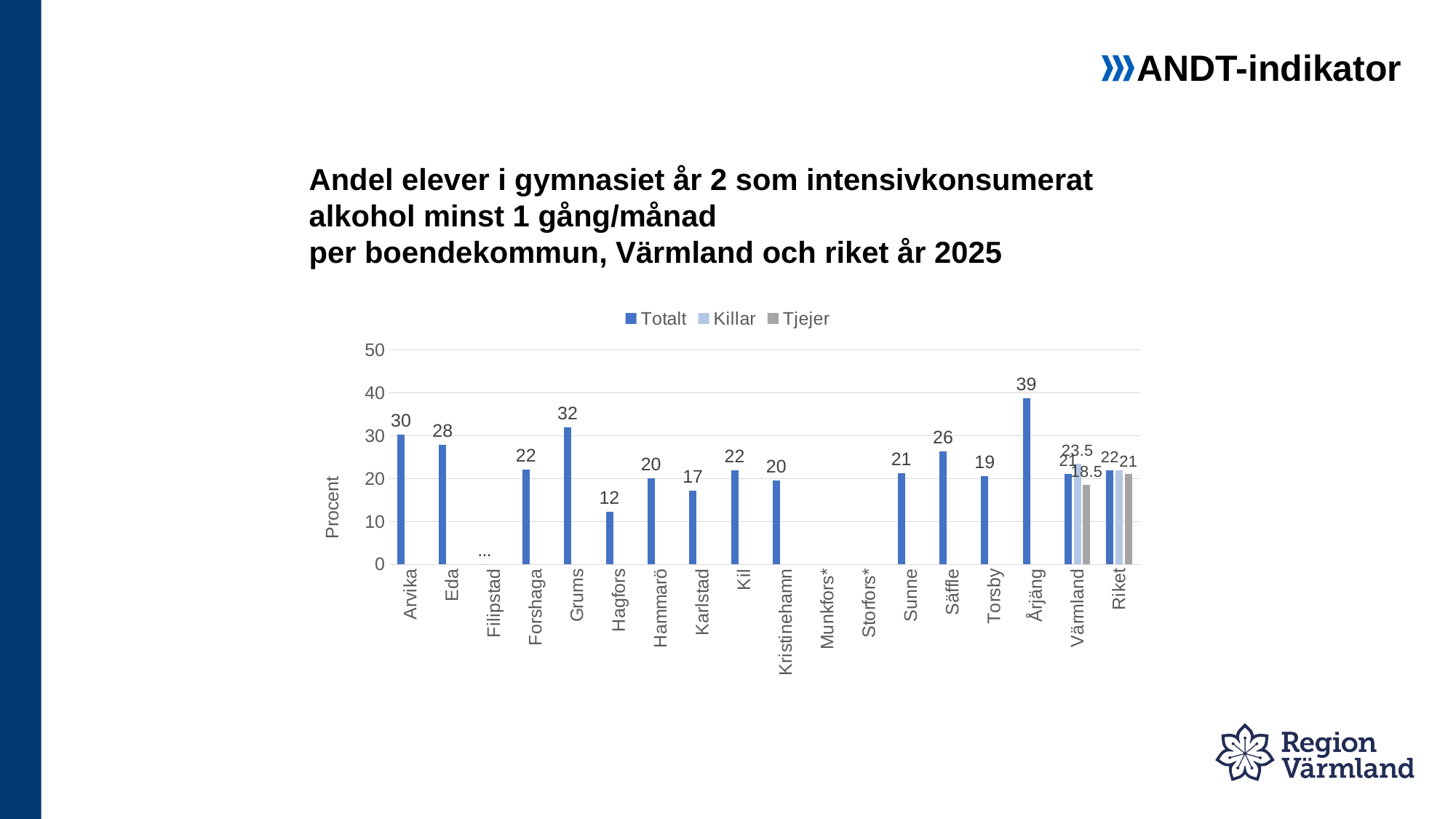
What is the Tjejer value for Värmland? 18.5 What is the Totalt value for Karlstad? 17 Which has a higher Totalt value, Arvika or Eda? Arvika Which municipality with a plotted value has the lowest Totalt value? Hagfors What is the difference between the Killar and Tjejer values for Värmland? 5 How many series does the legend list? 3 What is the Totalt value for Årjäng? 39 What is the difference between the Totalt values for Grums and Eda? 4 What kind of chart is shown on the slide? bar chart What is the Killar value for Värmland? 23.5 What is the label on the vertical axis? Procent Which municipality has the highest Totalt value? Årjäng